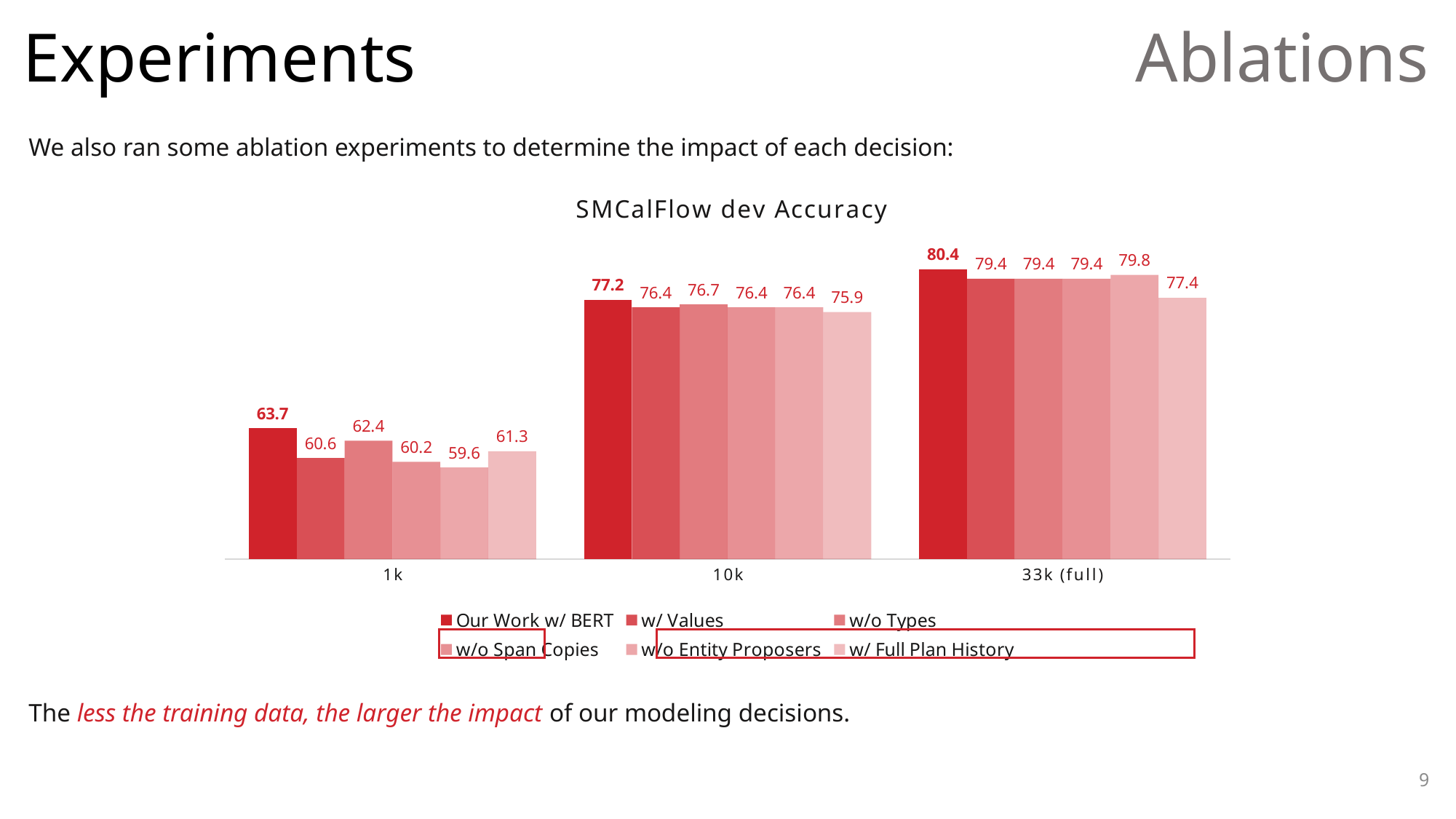
What is the value for w/ Full Plan History at 33k (full)? 77.4 How many training-data size categories are shown on the x axis? 3 Which is larger at 10k: w/o Types or w/ Full Plan History? w/o Types How many series does the legend list? 6 What is the value for Our Work w/ BERT at 1k? 63.7 Does the value for Our Work w/ BERT rise or fall as the training data size increases from 1k to 33k (full)? rise What is the difference between Our Work w/ BERT and w/o Entity Proposers at 1k? 4.1 What type of chart is shown on the slide? bar chart What is the title of the chart? SMCalFlow dev Accuracy Which series has the highest value at 33k (full)? Our Work w/ BERT Which series has the lowest value at 1k? w/o Entity Proposers What is the value for w/o Types at 10k? 76.7